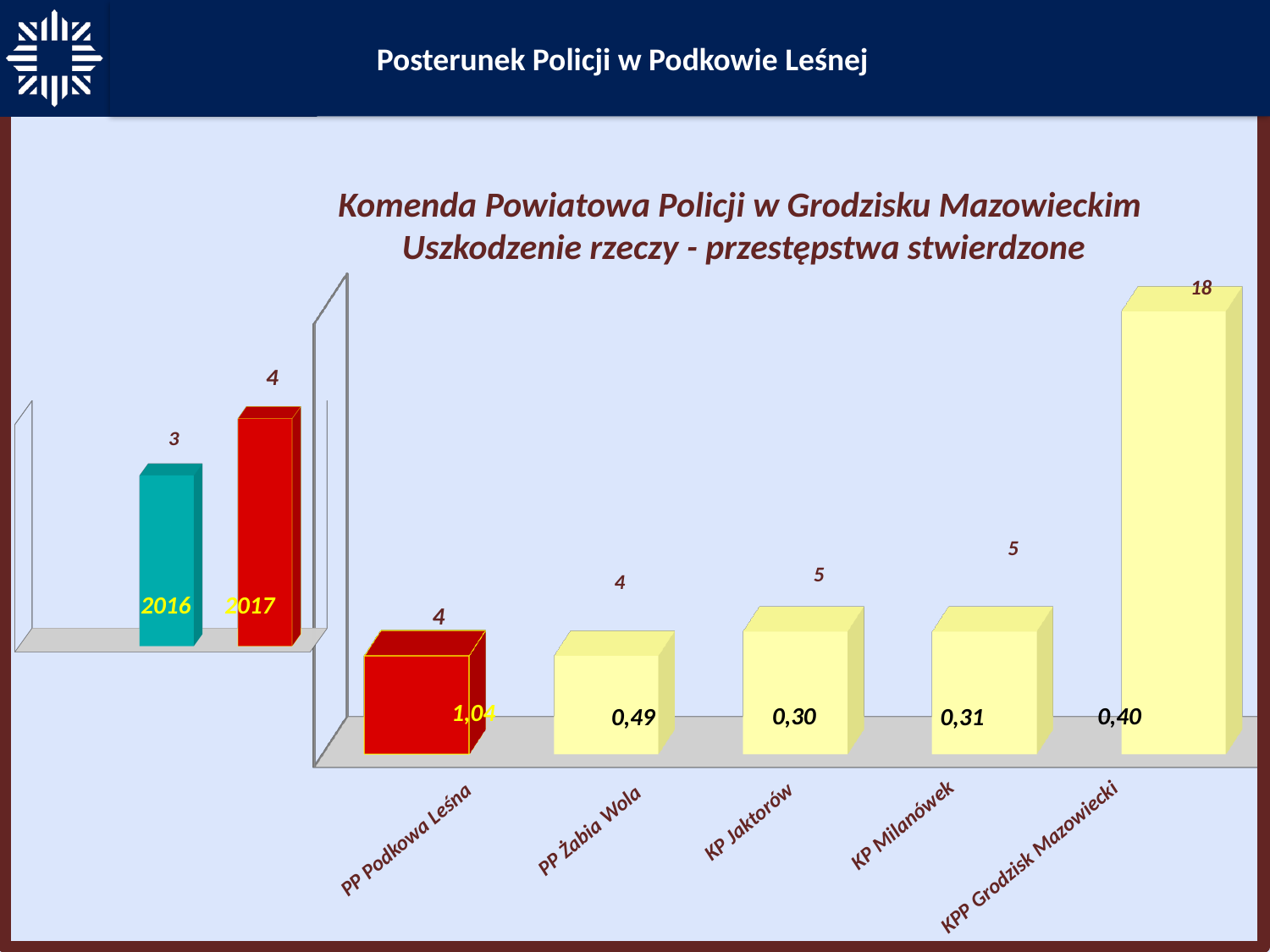
In the large chart on the right, what is the difference between the values for KPP Grodzisk Mazowiecki and KP Milanówek? 13 In the large chart on the right, which unit has the highest value? KPP Grodzisk Mazowiecki In the large chart on the right, how many units (categories) are shown? 5 In the large chart on the right, what is the lower label printed at the base of the PP Żabia Wola bar? 0,49 In the small chart on the left, what is the value for 2016? 3 In the small chart on the left, what is the difference between the 2017 and 2016 values? 1 In the large chart on the right, what is the lower label printed at the base of the PP Podkowa Leśna bar? 1,04 In the large chart on the right, what is the value for KP Jaktorów? 5 In the large chart on the right, what is the value for KPP Grodzisk Mazowiecki? 18 In the small chart on the left, which year has the higher value, 2016 or 2017? 2017 In the small chart on the left, what is the value for 2017? 4 What type of chart is the large chart on the right? Bar chart